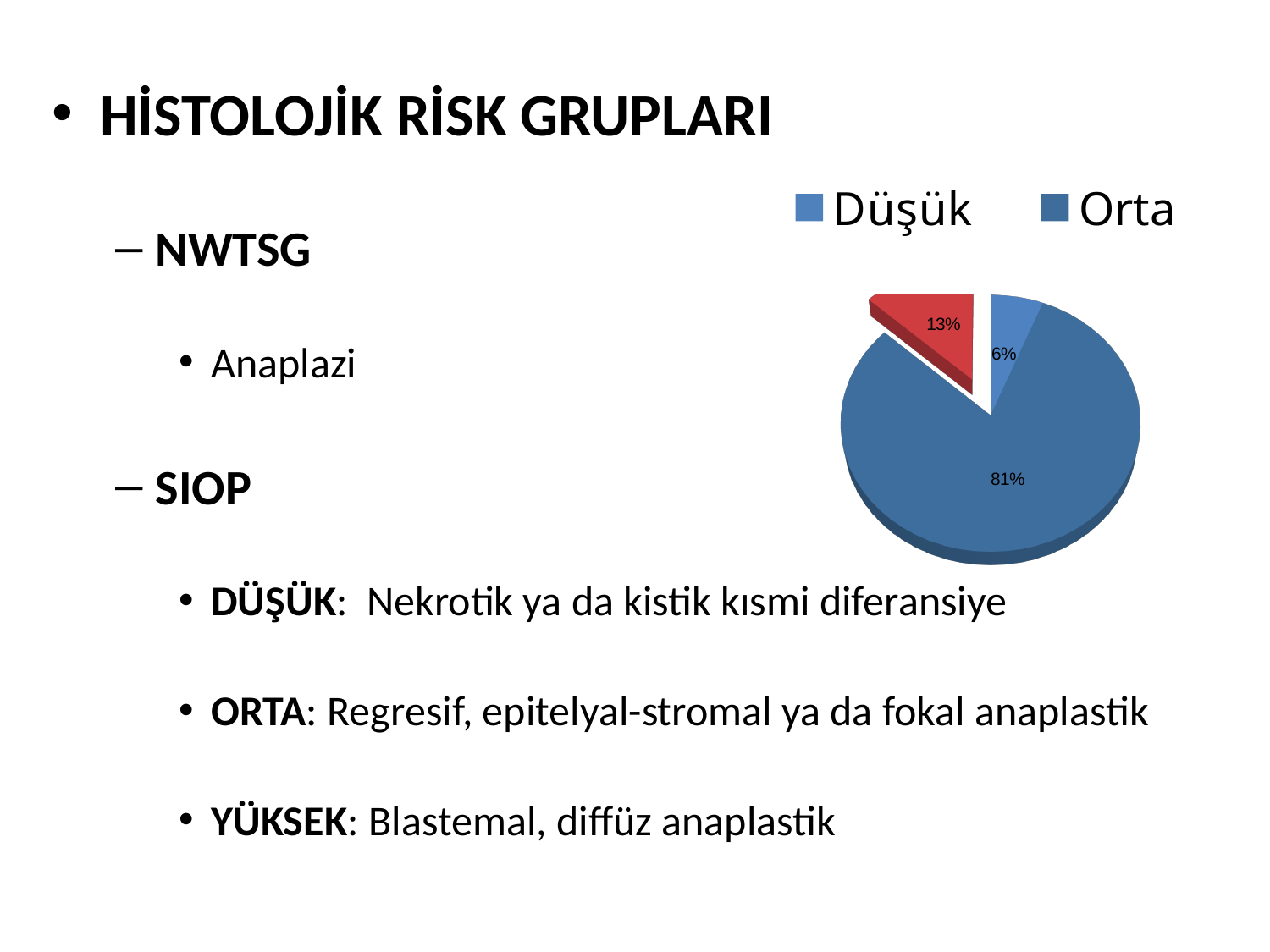
What colour is the Orta slice in the pie chart? dark blue Which slice of the pie chart is the largest? Orta How many slices does the pie chart have? 3 Which is larger in the pie chart, Düşük or Orta? Orta What percentage is printed on the red slice of the pie chart? 13% What share of the pie does the Düşük slice represent? 6% What kind of chart is shown on the slide? pie chart What percentage is shown for the Orta slice of the pie chart? 81% Which two legend entries are readable above the pie chart? Düşük and Orta Which slice of the pie chart is the smallest? Düşük What is the difference in percentage points between the Orta slice and the Düşük slice? 75% What percentage is shown for the Düşük slice of the pie chart? 6%